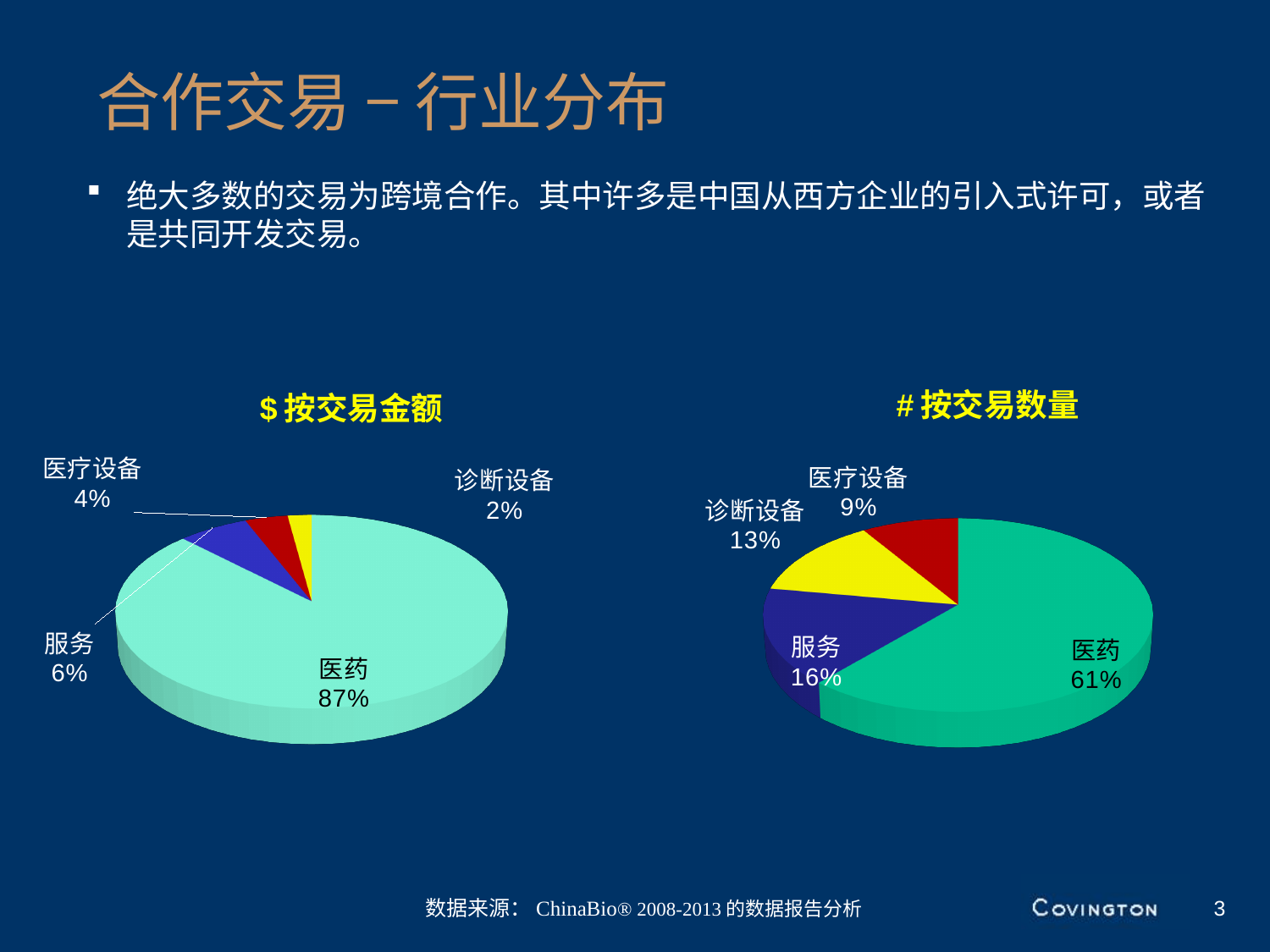
In the "# 按交易数量" pie chart, what is the difference between the shares of 服务 and 医疗设备? 7% In the "$ 按交易金额" pie chart, which category has the smallest share? 诊断设备 In the "$ 按交易金额" pie chart, how many slices are there? 4 In the "$ 按交易金额" pie chart, what share does 医药 have? 87% In the "$ 按交易金额" pie chart, what share does 服务 have? 6% In the "# 按交易数量" pie chart, what share does 医药 have? 61% In the "$ 按交易金额" pie chart, what is the difference between the shares of 医疗设备 and 诊断设备? 2% In the "# 按交易数量" pie chart, which is larger, 服务 or 医疗设备? 服务 In the "# 按交易数量" pie chart, which category has the largest share? 医药 What type of chart is used on the left side of the slide? Pie chart In the "# 按交易数量" pie chart, what share does 诊断设备 have? 13% What is the title of the chart on the right side of the slide? # 按交易数量